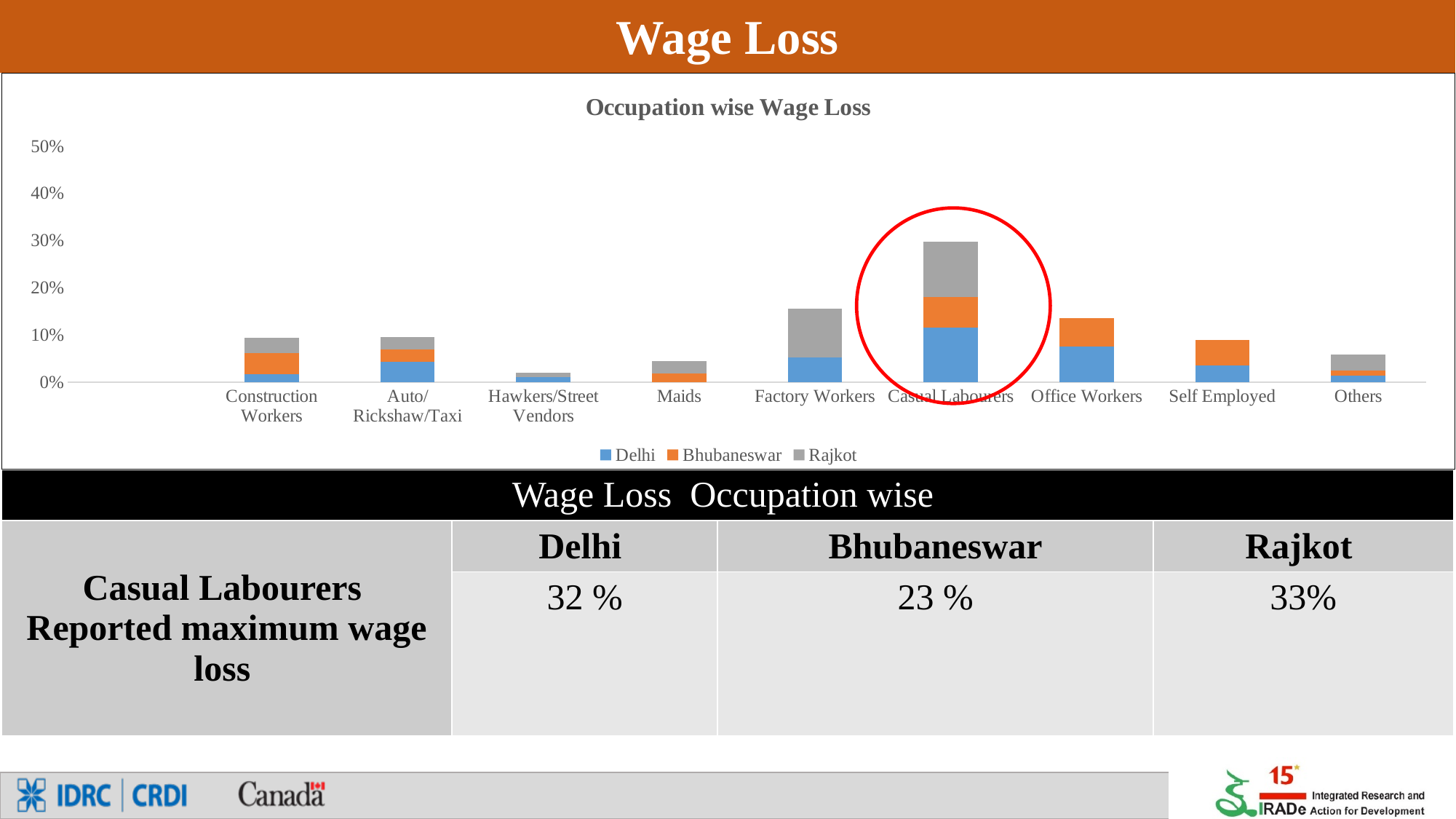
Is the total stacked value for Hawkers/Street Vendors greater or less than 10%? less How many occupation categories are shown on the x axis of the chart? 9 Is the total stacked value for Others greater or less than 10%? less Is the total stacked value for Factory Workers greater or less than 10%? greater What is the title of the chart? Occupation wise Wage Loss Which colour represents Rajkot in the chart legend? Grey Which occupation has the lowest total stacked wage loss in the chart? Hawkers/Street Vendors How many series does the chart legend list? 3 Which has the larger total stacked wage loss, Casual Labourers or Factory Workers? Casual Labourers What kind of chart is shown on the slide? Stacked bar chart Which occupation has the highest total stacked wage loss in the chart? Casual Labourers